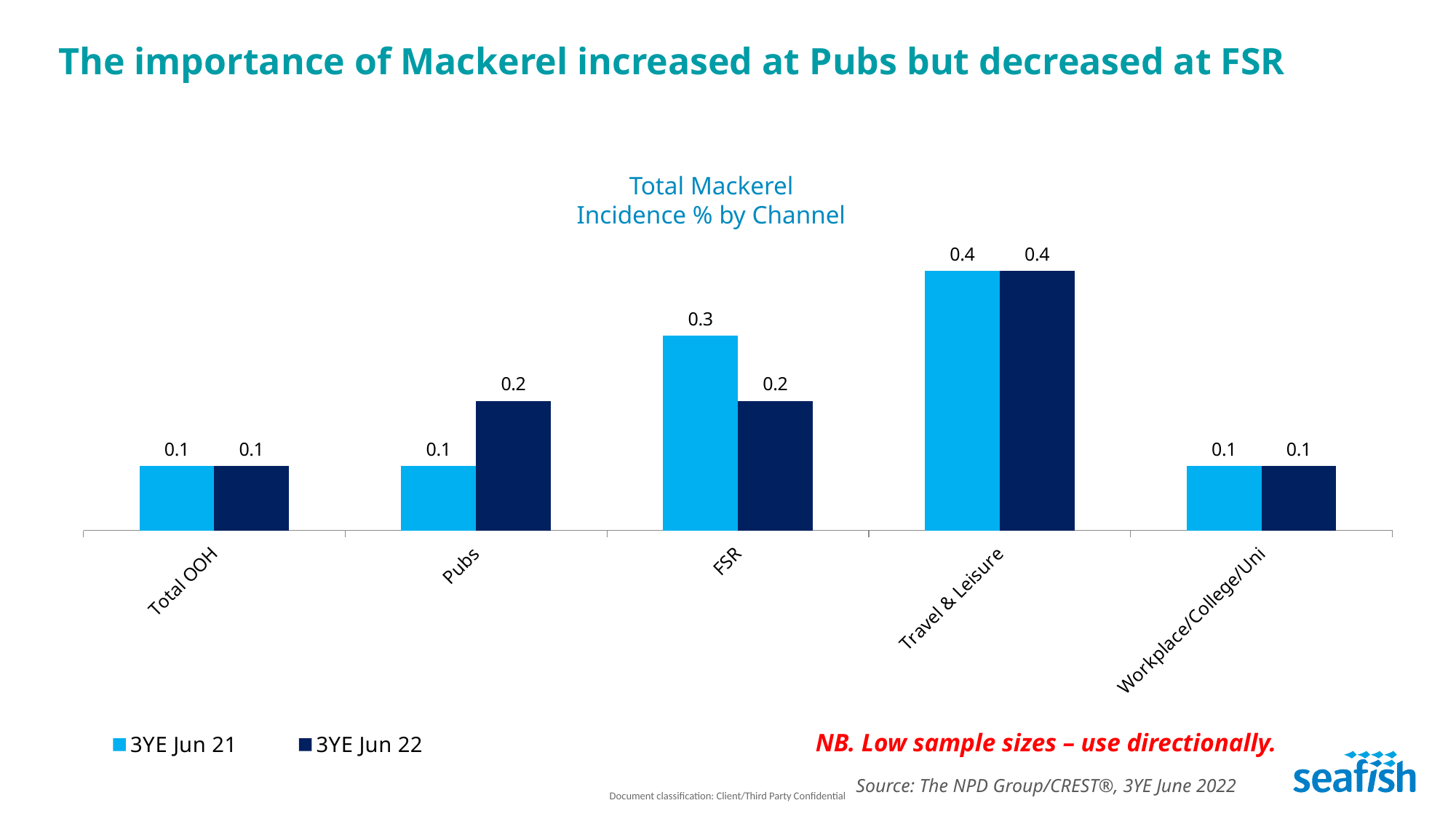
What is the value for Pubs in the 3YE Jun 22 series? 0.2 What kind of chart is shown on the slide? Bar chart Which channel has the lowest value in the 3YE Jun 22 series, other than those tied at 0.1? Pubs and FSR (tied at 0.2) Which channel has the highest value in the 3YE Jun 21 series? Travel & Leisure What is the value for Travel & Leisure in the 3YE Jun 22 series? 0.4 How many series does the legend list? 2 What is the title of the chart? Total Mackerel Incidence % by Channel How many channels are shown on the x axis? 5 What is the value for FSR in the 3YE Jun 21 series? 0.3 Which is larger for FSR: the 3YE Jun 21 value or the 3YE Jun 22 value? 3YE Jun 21 What is the difference between the 3YE Jun 21 and 3YE Jun 22 values for FSR? 0.1 Which is larger for Pubs: the 3YE Jun 21 value or the 3YE Jun 22 value? 3YE Jun 22